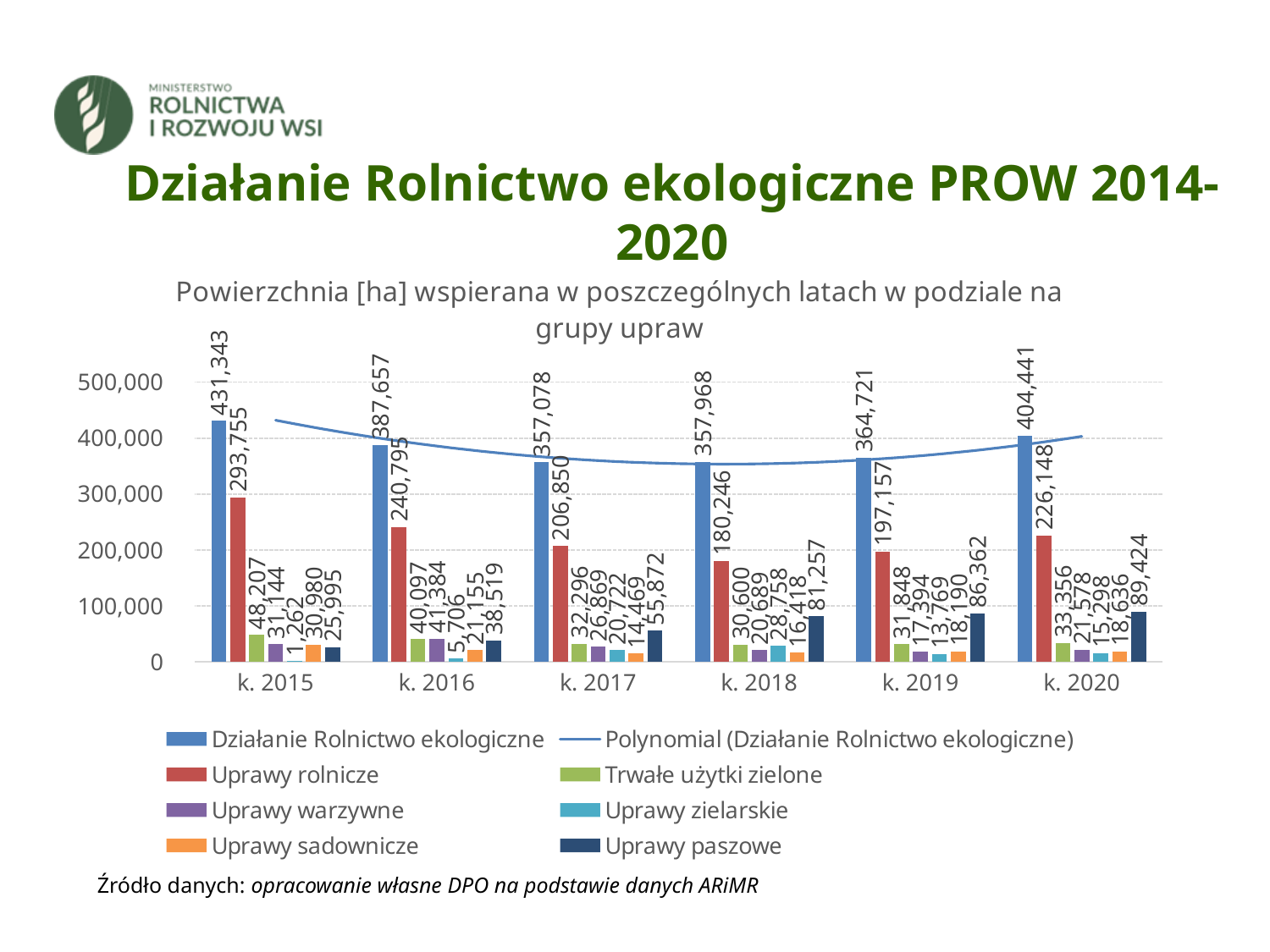
What is the value for Uprawy rolnicze in k. 2018? 180,246 What kind of chart is shown on the slide? bar chart What is the difference between the Działanie Rolnictwo ekologiczne values for k. 2015 and k. 2020? 26,902 In which year is the value for Działanie Rolnictwo ekologiczne the highest? k. 2015 What is the value for Działanie Rolnictwo ekologiczne in k. 2015? 431,343 Which is larger: Uprawy paszowe in k. 2019 or in k. 2020? k. 2020 How many entries does the legend list? 8 What is the value for Uprawy paszowe in k. 2020? 89,424 What is the value for Uprawy warzywne in k. 2016? 41,384 How many years (categories) are shown on the x axis? 6 Do the values for Uprawy paszowe rise or fall from k. 2017 to k. 2020? rise In which year is the value for Uprawy rolnicze the lowest? k. 2018